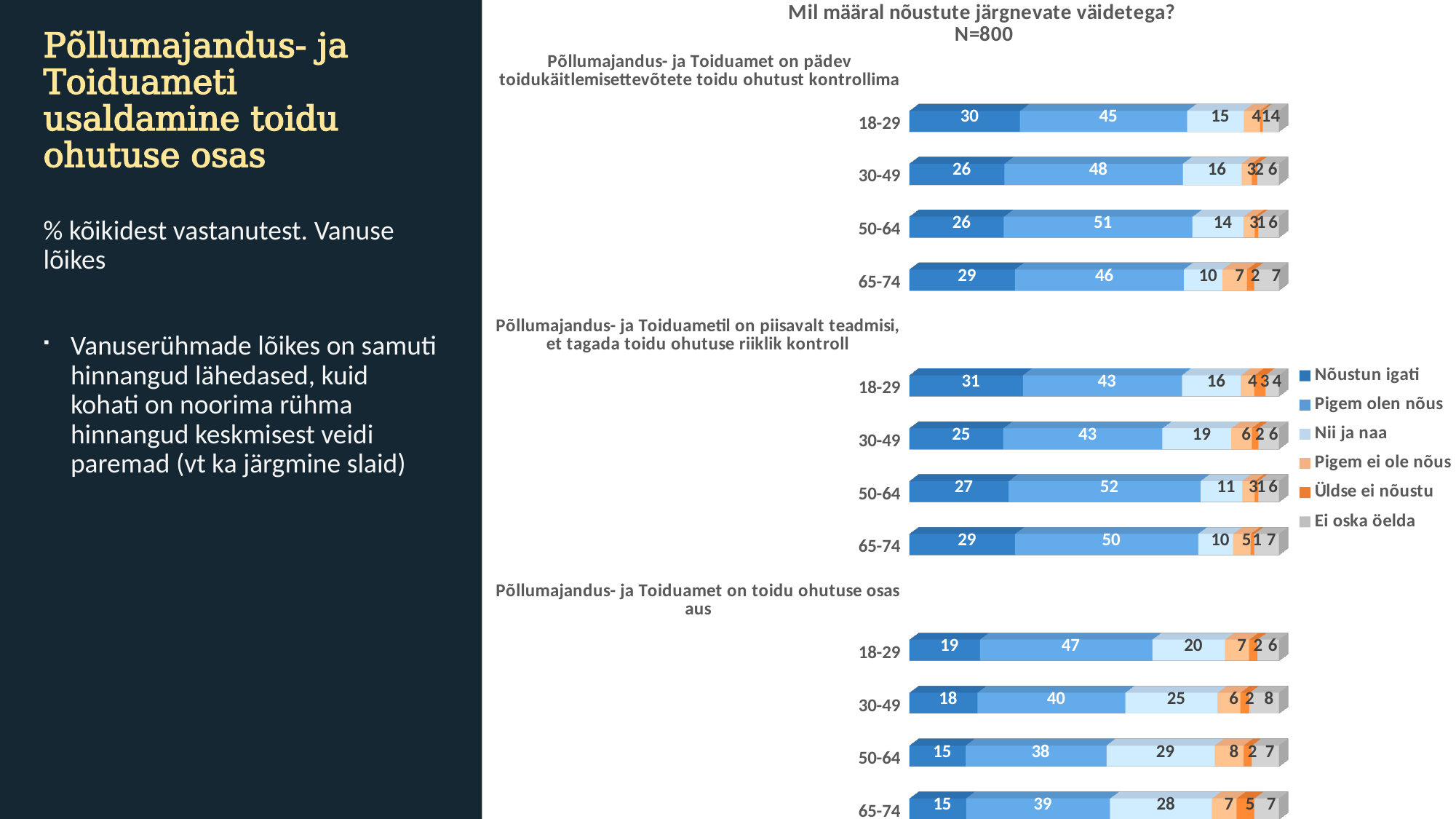
In the statement 'Põllumajandus- ja Toiduamet on pädev toidukäitlemisettevõtete toidu ohutust kontrollima', what is the value of 'Nõustun igati' for the 18-29 age group? 30 How many series does the legend list? 6 What kind of chart is shown on the slide? Stacked bar chart In the statement 'Põllumajandus- ja Toiduamet on toidu ohutuse osas aus', what is the difference between the 'Pigem olen nõus' values for 18-29 and 30-49? 7 In the statement 'Põllumajandus- ja Toiduamet on toidu ohutuse osas aus', what is the value of 'Nii ja naa' for the 50-64 age group? 29 In the statement 'Põllumajandus- ja Toiduametil on piisavalt teadmisi, et tagada toidu ohutuse riiklik kontroll', what is the value of 'Pigem olen nõus' for the 50-64 age group? 52 How many age groups are shown for each statement? 4 In the statement 'Põllumajandus- ja Toiduametil on piisavalt teadmisi, et tagada toidu ohutuse riiklik kontroll', which age group has the larger 'Nõustun igati' value, 18-29 or 30-49? 18-29 In the statement 'Põllumajandus- ja Toiduamet on pädev toidukäitlemisettevõtete toidu ohutust kontrollima', which age group has the highest 'Nõustun igati' value? 18-29 What is the sample size (N) stated in the chart title? N=800 In the statement 'Põllumajandus- ja Toiduamet on pädev toidukäitlemisettevõtete toidu ohutust kontrollima', which age group has the lowest 'Nii ja naa' value? 65-74 In the statement 'Põllumajandus- ja Toiduamet on toidu ohutuse osas aus', what is the total of all segments for the 30-49 age group? 99